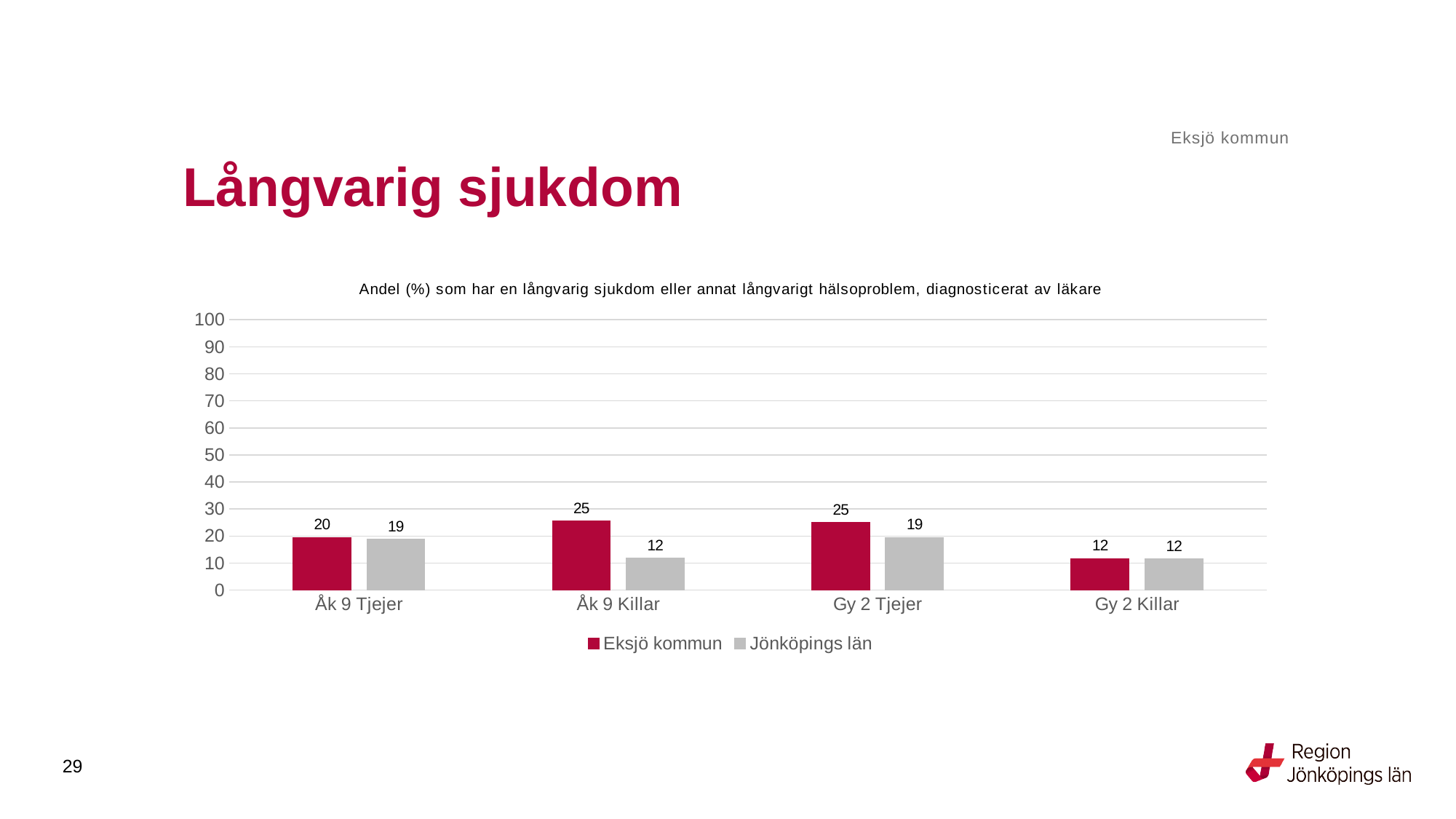
How many categories are shown on the x axis? 4 Which is larger in the Gy 2 Tjejer category: Eksjö kommun or Jönköpings län? Eksjö kommun What is the value for Jönköpings län in the Åk 9 Killar category? 12 What is the difference between Eksjö kommun and Jönköpings län in the Åk 9 Killar category? 13 What is the value for Eksjö kommun in the Gy 2 Tjejer category? 25 How many series does the legend list? 2 Is the value for Eksjö kommun in Åk 9 Killar greater or less than 50? less What is the value for Eksjö kommun in the Åk 9 Tjejer category? 20 What is the value for Jönköpings län in the Gy 2 Killar category? 12 What kind of chart is shown on the slide? bar chart Which category has the lowest value for Eksjö kommun? Gy 2 Killar What colour are the bars for Eksjö kommun? red